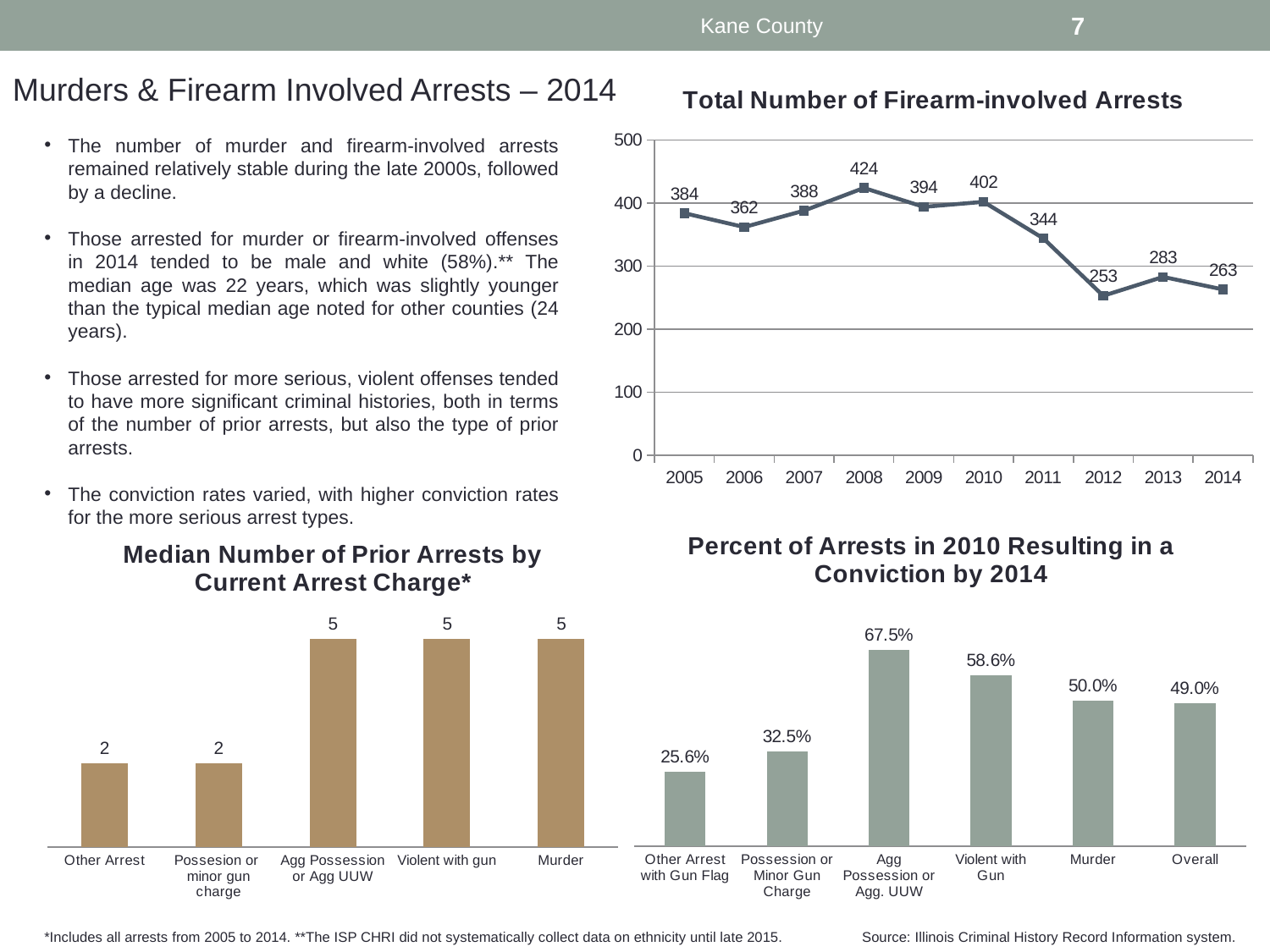
In the 'Total Number of Firearm-involved Arrests' chart, do values rise or fall from 2010 to 2012? fall In the 'Percent of Arrests in 2010 Resulting in a Conviction by 2014' chart, which is larger: Violent with Gun or Murder? Violent with Gun In the 'Median Number of Prior Arrests by Current Arrest Charge' chart, what is the value for Murder? 5 In the 'Total Number of Firearm-involved Arrests' chart, what is the difference between the 2005 and 2014 values? 121 In the 'Total Number of Firearm-involved Arrests' chart, which year has the lowest value? 2012 In the 'Percent of Arrests in 2010 Resulting in a Conviction by 2014' chart, which category has the highest value? Agg Possession or Agg. UUW What kind of chart is 'Percent of Arrests in 2010 Resulting in a Conviction by 2014'? bar chart In the 'Total Number of Firearm-involved Arrests' chart, how many years are plotted? 10 In the 'Median Number of Prior Arrests by Current Arrest Charge' chart, how many categories are shown? 5 What kind of chart is 'Total Number of Firearm-involved Arrests'? line chart In the 'Total Number of Firearm-involved Arrests' chart, what is the value for 2008? 424 In the 'Percent of Arrests in 2010 Resulting in a Conviction by 2014' chart, what is the value for Overall? 49.0%